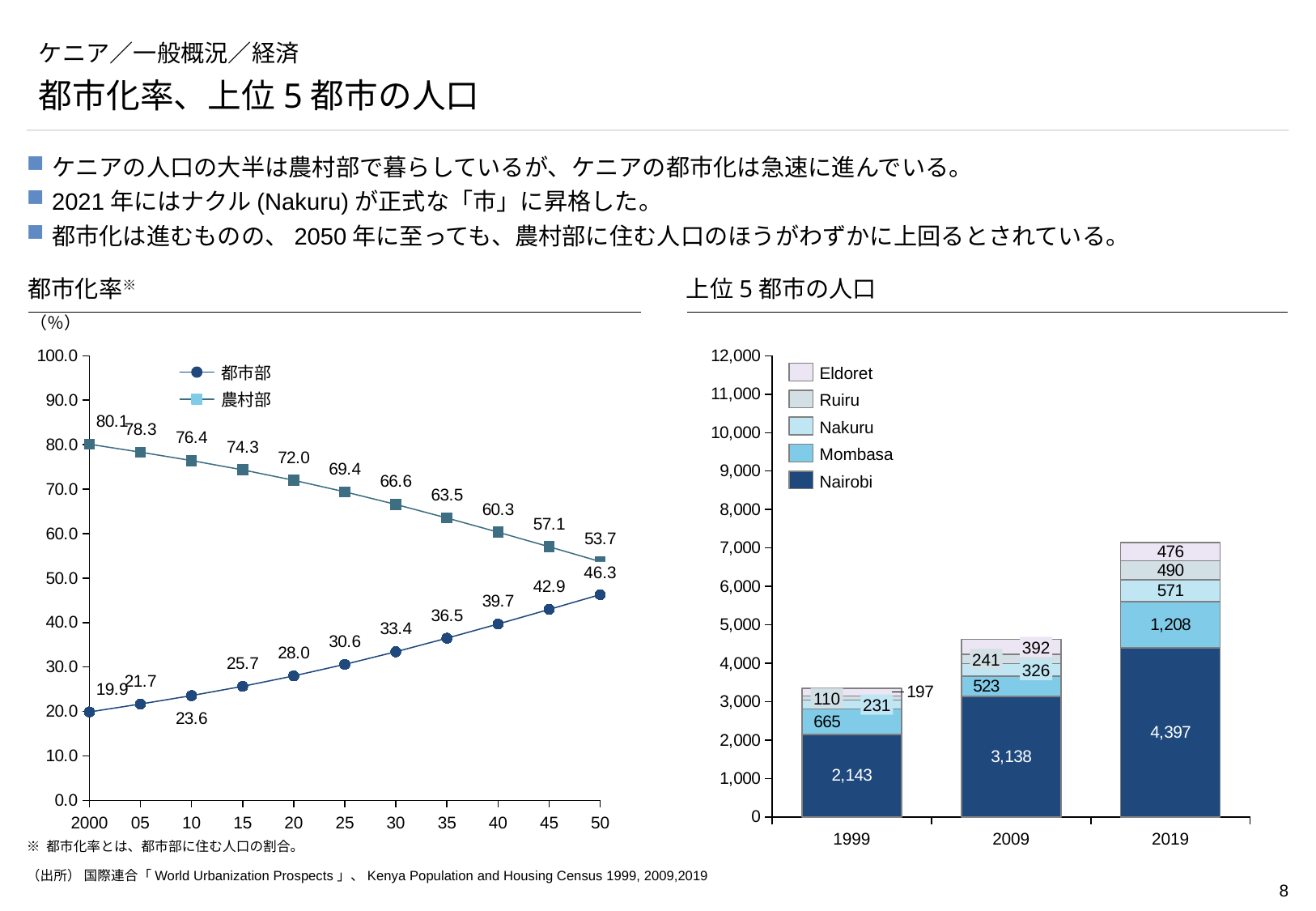
In the 上位5都市の人口 chart on the right, is the total for 1999 greater or less than 4,000? less In the 上位5都市の人口 chart on the right, what is the value for Nairobi in 2019? 4,397 In the 上位5都市の人口 chart on the right, how many series does the legend list? 5 In the 上位5都市の人口 chart on the right, what is the total of the stacked bar for 2019? 7,142 In the 都市化率 chart on the left, what is the value for 都市部 in 2000? 19.9 In the 上位5都市の人口 chart on the right, which year has the highest Nairobi value? 2019 In the 都市化率 chart on the left, what is the value for 農村部 in 2050? 53.7 In the 都市化率 chart on the left, what is the difference between the 農村部 and 都市部 values in 2000? 60.2 In the 都市化率 chart on the left, how many series does the legend list? 2 In the 都市化率 chart on the left, does the 都市部 series rise or fall from 2000 to 2050? rise What kind of chart is the 都市化率 chart on the left? line chart In the 上位5都市の人口 chart on the right, what is the value for Mombasa in 2009? 523